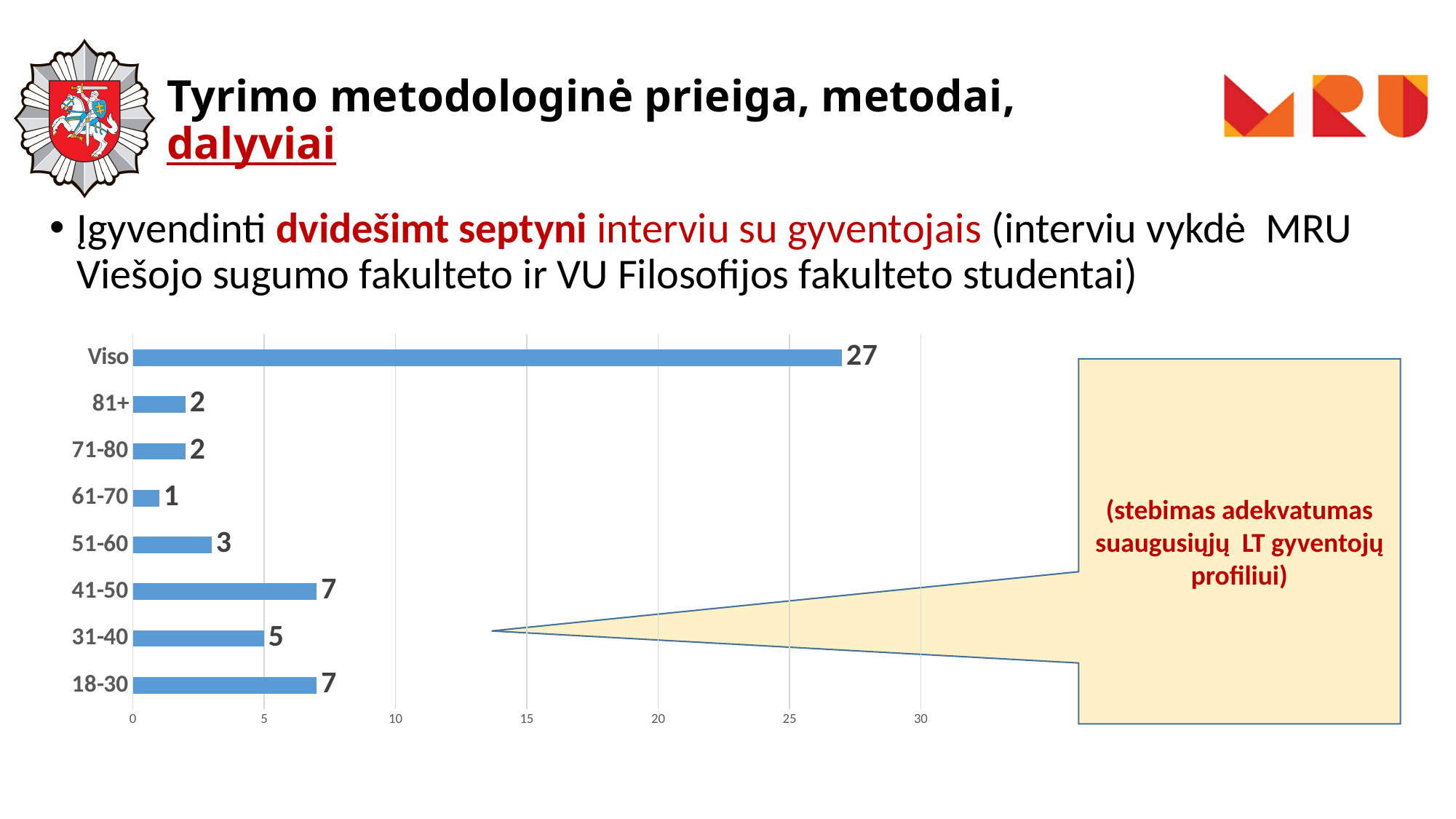
What is the value for the 18-30 category? 7 What is the difference between the values for 41-50 and 51-60? 4 What colour are the bars in the chart? blue Is the value for Viso greater or less than 25? greater What is the value for the 31-40 category? 5 What is the value for the Viso category? 27 Excluding the Viso total bar, which age category has the lowest value? 61-70 How many categories are shown on the chart? 8 What is the value for the 61-70 category? 1 What is the difference between the values for Viso and 18-30? 20 Which is larger, the value for 31-40 or the value for 51-60? 31-40 What kind of chart is shown on the slide? bar chart